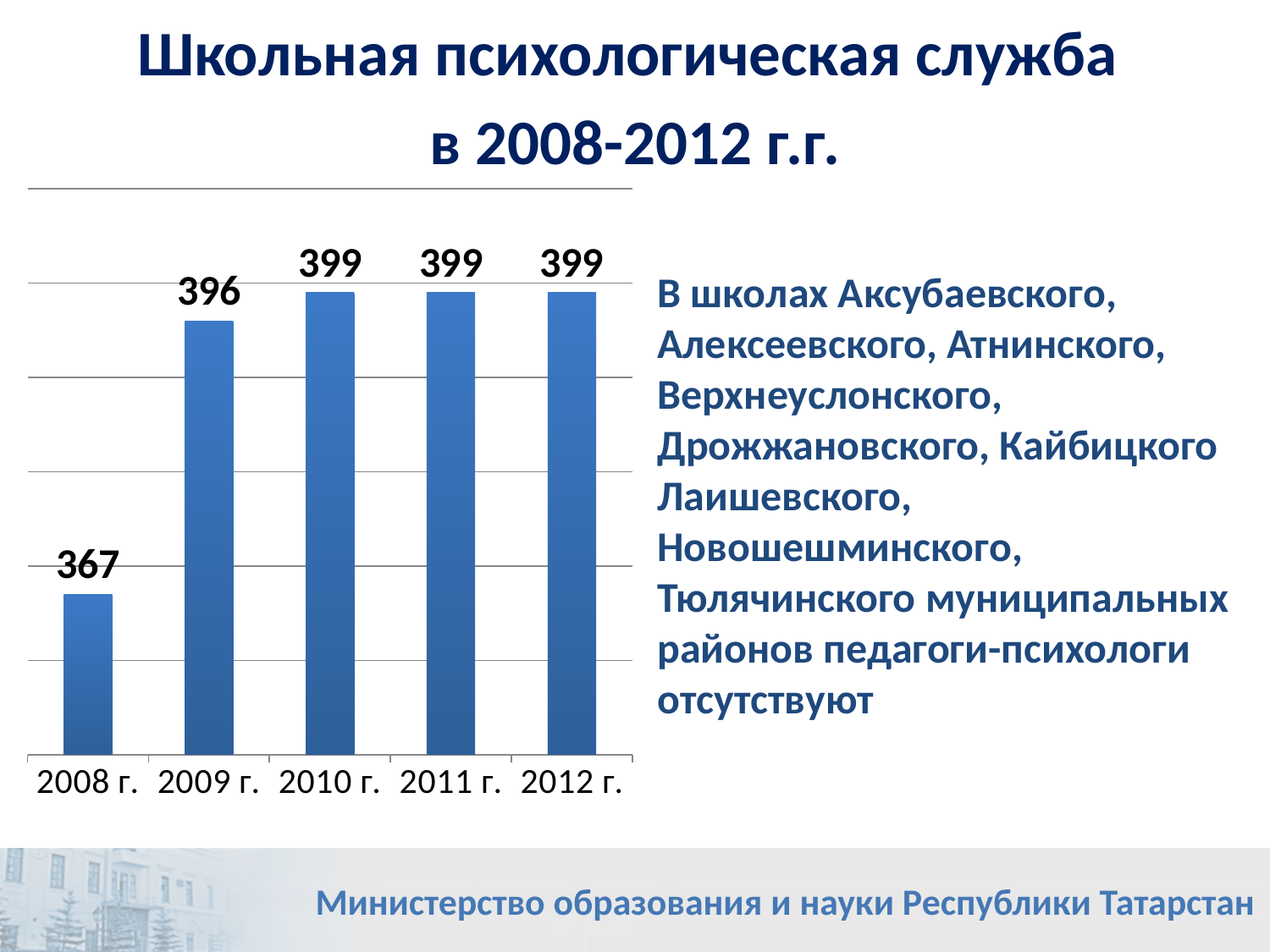
What is the highest value shown in the chart? 399 What is the value for 2012 г.? 399 What is the value for 2009 г.? 396 What is the difference between the values for 2010 г. and 2009 г.? 3 What is the difference between the values for 2009 г. and 2008 г.? 29 What kind of chart is shown on the slide? bar chart What is the value for 2010 г.? 399 What is the value for 2008 г.? 367 Which year has the lowest value? 2008 г. Do the values rise or fall from 2008 г. to 2010 г.? rise How many years are shown on the x axis of the chart? 5 Which is larger, the value for 2008 г. or the value for 2009 г.? 2009 г.